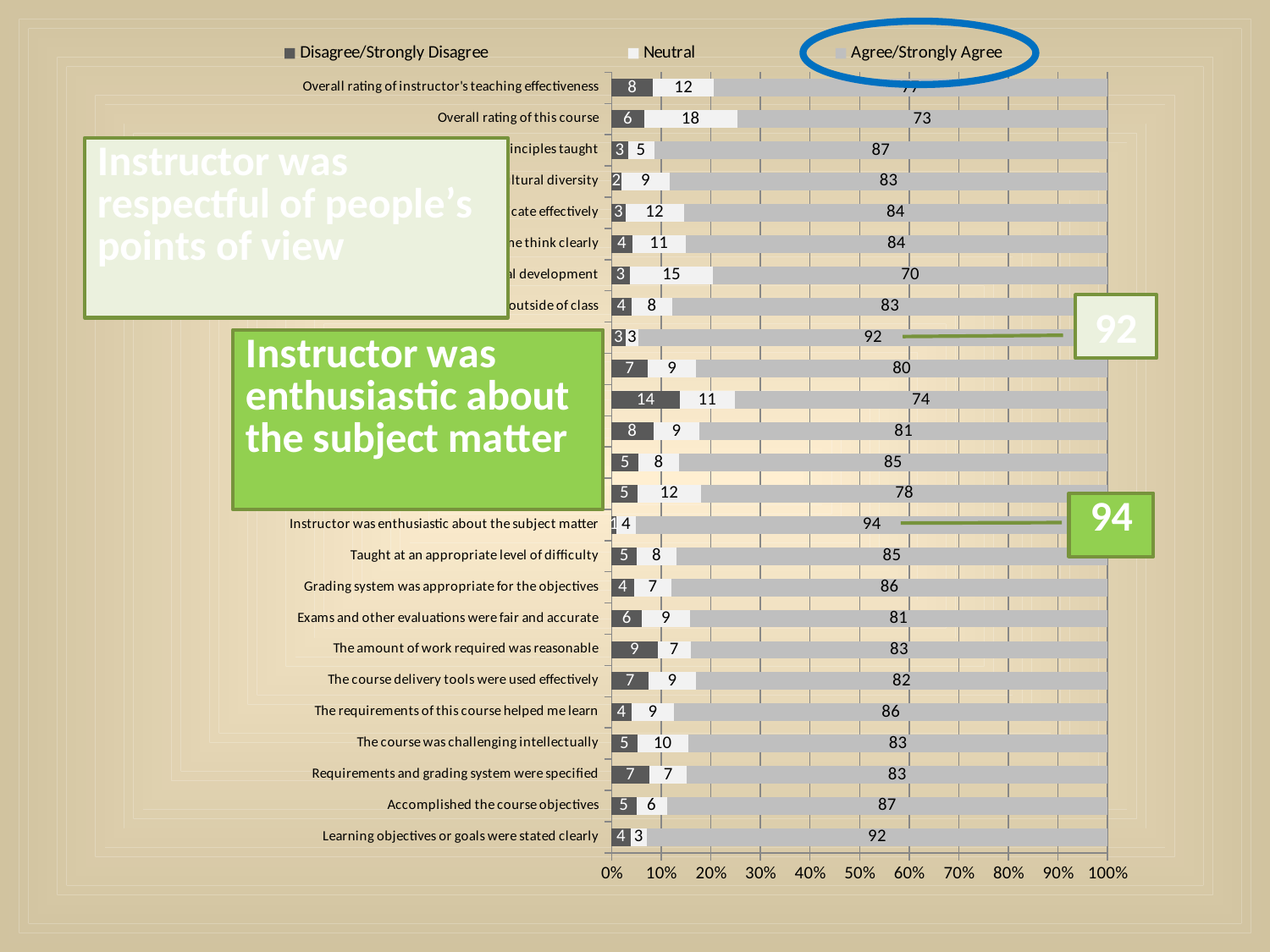
What is the Disagree/Strongly Disagree value for "The amount of work required was reasonable"? 9 What is the Neutral value for "The course was challenging intellectually"? 10 What is the Agree/Strongly Agree value for "Instructor was enthusiastic about the subject matter"? 94 Which category has the highest Agree/Strongly Agree value? Instructor was enthusiastic about the subject matter How many series does the legend list? 3 Which legend entry is circled in blue? Agree/Strongly Agree Which has a larger Agree/Strongly Agree value: "Grading system was appropriate for the objectives" or "The course delivery tools were used effectively"? Grading system was appropriate for the objectives What kind of chart is shown on the slide? Stacked bar chart What is the Neutral value for "Overall rating of this course"? 18 What is the total of the three values for "Learning objectives or goals were stated clearly"? 99 What is the difference between the Agree/Strongly Agree values for "Accomplished the course objectives" and "Exams and other evaluations were fair and accurate"? 6 What is the Agree/Strongly Agree value for "Learning objectives or goals were stated clearly"? 92